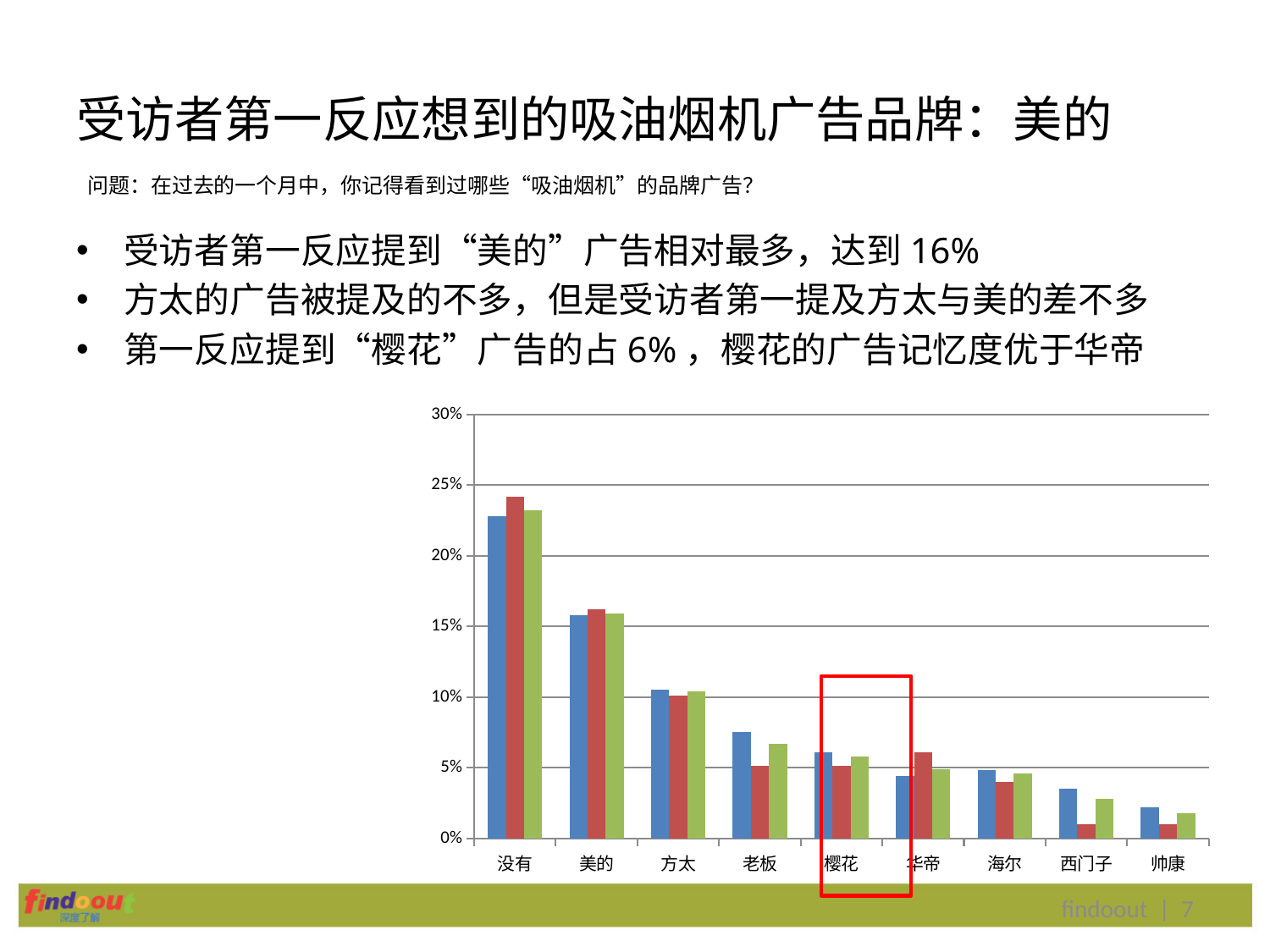
Is the red bar for 美的 greater or less than 15%? greater Is the blue bar for 老板 greater or less than 5%? greater Moving from 美的 to 帅康 along the x axis, do the bar values generally rise or fall? fall How many bars are plotted for each category in the chart? 3 Is the blue bar for 没有 greater or less than 20%? greater Which has the larger red bar, 樱花 or 华帝? 华帝 How many categories are shown on the x axis of the chart? 9 What kind of chart is shown on the slide? bar chart Among the blue bars, which category has the lowest value? 帅康 Which has the larger blue bar, 老板 or 樱花? 老板 Which category has the highest bars in the chart? 没有